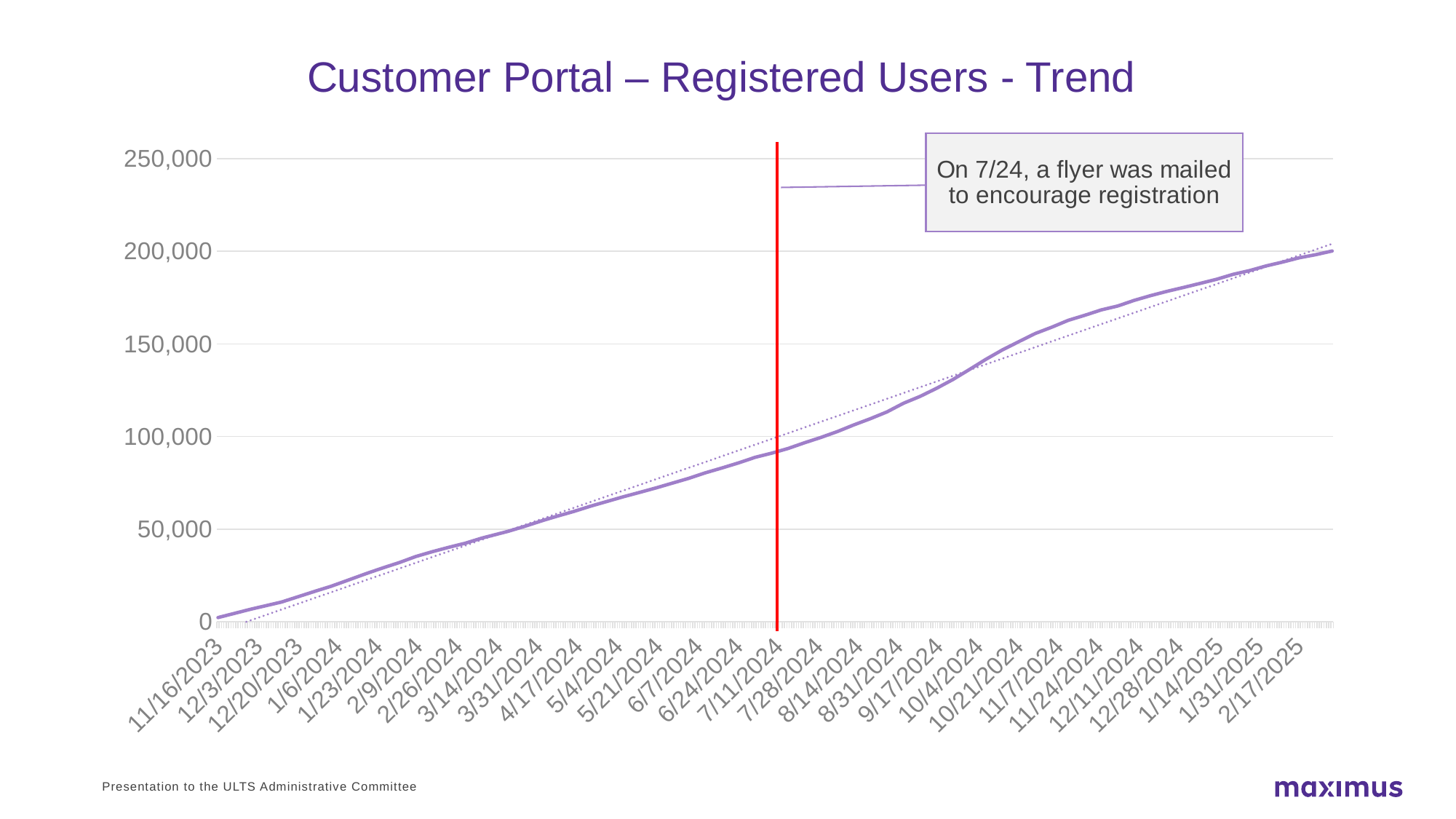
Is the value for 7/11/2024 greater or less than 100,000? less Is the value for 5/21/2024 greater or less than 50,000? greater Do the registered user values rise or fall over time along the x axis? rise What is the title of the chart? Customer Portal – Registered Users - Trend What kind of chart is shown on the slide? line chart Is the value for 10/4/2024 greater or less than 150,000? less What event does the annotation say happened on 7/24? a flyer was mailed to encourage registration Which date on the x axis has the lowest number of registered users? 11/16/2023